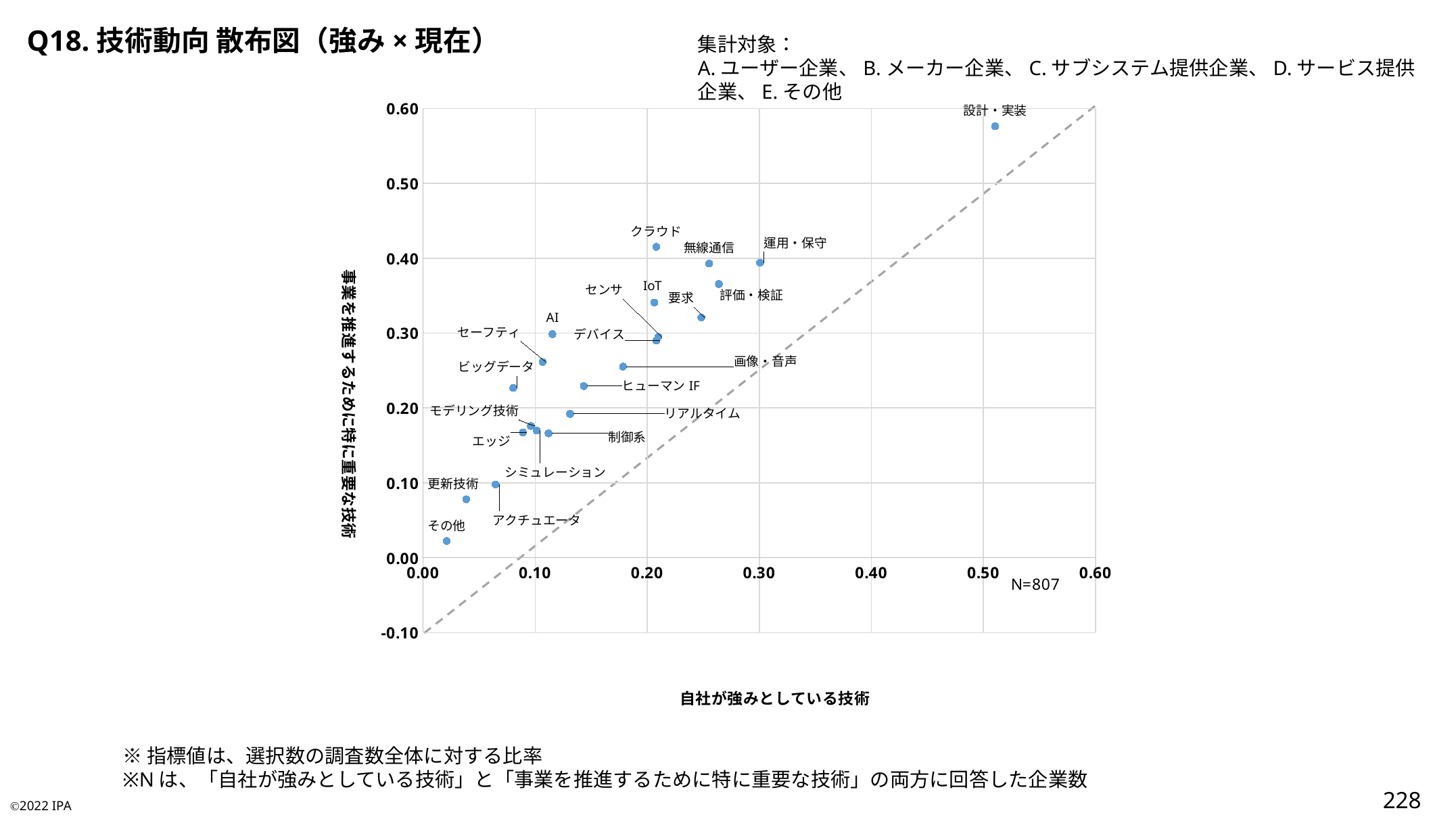
Which technology has the lowest value on the vertical axis? その他 Is the horizontal-axis value for 設計・実装 greater or less than 0.40? greater What is the title of the horizontal axis? 自社が強みとしている技術 Is the vertical-axis value for 更新技術 greater or less than 0.10? less Which technology has the highest value on the vertical axis (事業を推進するために特に重要な技術)? 設計・実装 Is the vertical-axis value for 設計・実装 greater or less than 0.50? greater Which has the larger horizontal-axis value, 設計・実装 or クラウド? 設計・実装 How many labelled data points are plotted on the chart? 22 What kind of chart is shown on the slide? scatter chart Which has the larger vertical-axis value, AI or 更新技術? AI